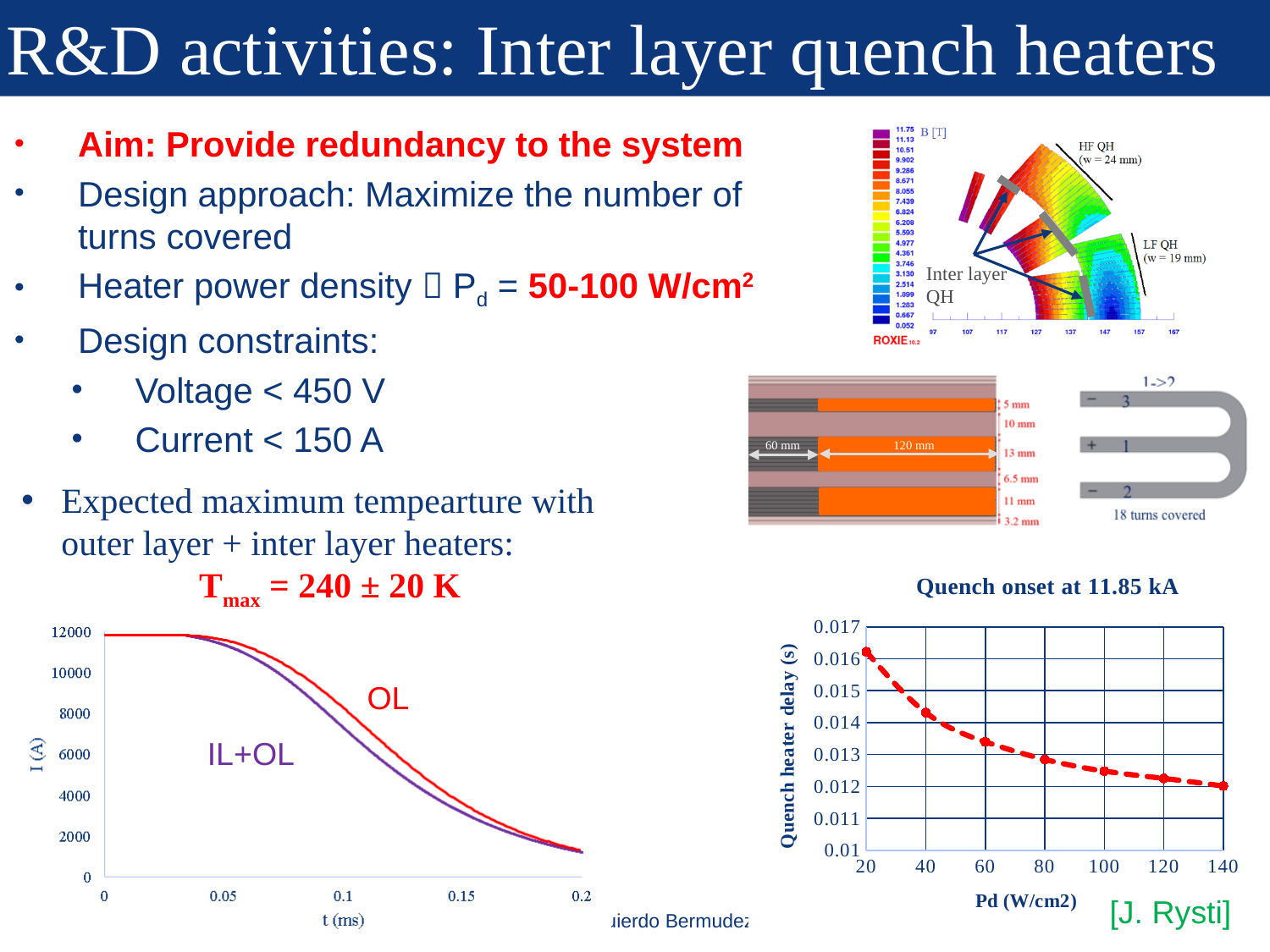
What is the title of the bottom-right chart? Quench onset at 11.85 kA In the bottom-left chart of I (A) versus t (ms), what is the current at t = 0? 12000 In the bottom-left chart of I (A) versus t (ms), is the current at t = 0.2 ms greater or less than 2000? less In the bottom-left chart of I (A) versus t (ms), does the current rise or fall as t increases? fall In the 'Quench onset at 11.85 kA' chart, does the quench heater delay rise or fall as Pd increases? fall What kind of chart is the bottom-left chart of I (A) versus t (ms)? line chart In the bottom-left chart of I (A) versus t (ms), at t = 0.1 ms which series has the larger current, OL or IL+OL? OL In the bottom-left chart of I (A) versus t (ms), what colour is the OL curve? red In the bottom-left chart of I (A) versus t (ms), how many series are plotted? 2 In the 'Quench onset at 11.85 kA' chart, is the quench heater delay at Pd = 20 W/cm2 greater or less than 0.015? greater In the 'Quench onset at 11.85 kA' chart, is the quench heater delay at Pd = 120 W/cm2 greater or less than 0.013? less